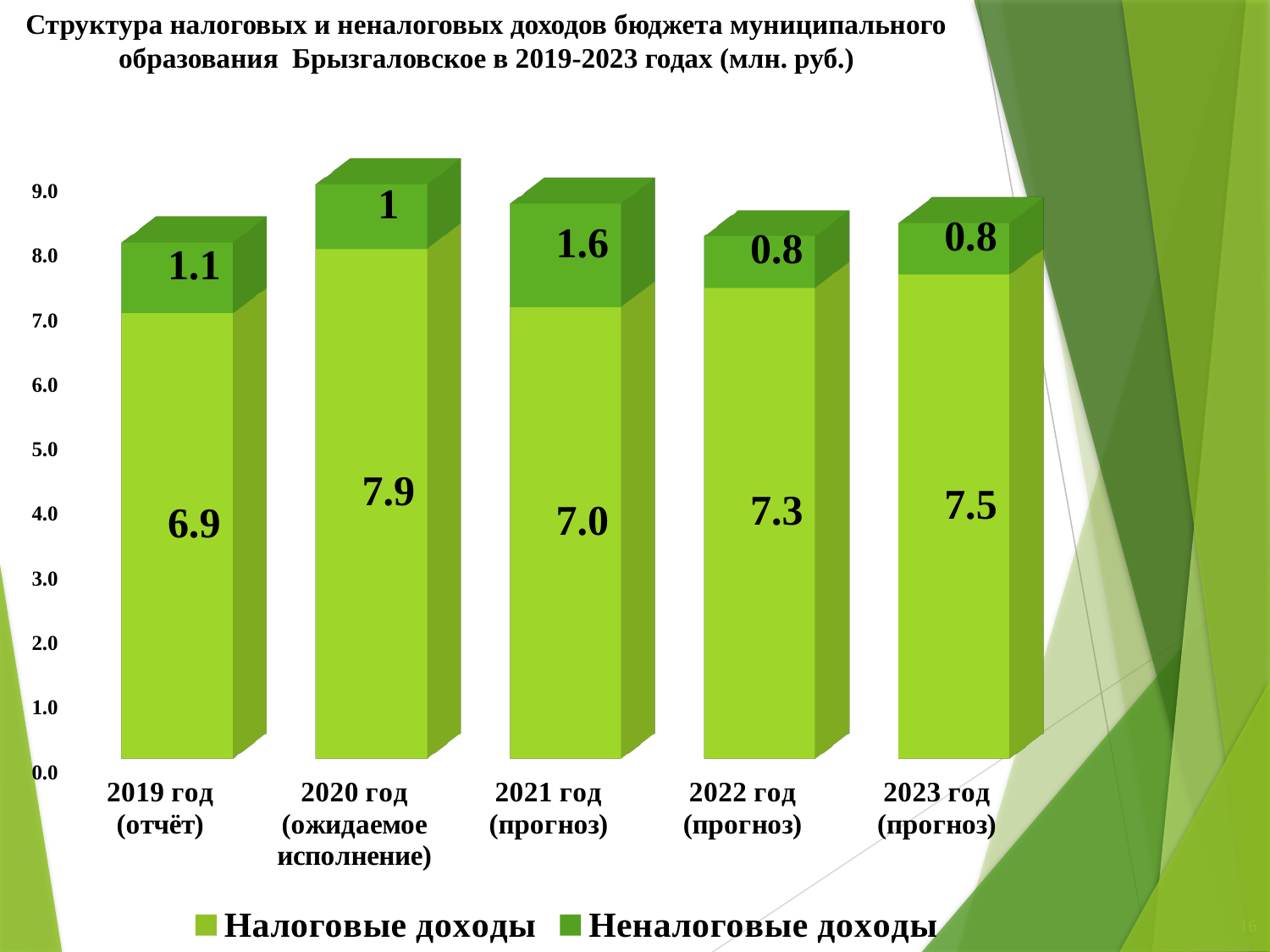
Which year has the highest value of Неналоговые доходы? 2021 год (прогноз) How many series does the legend list? 2 How many years (categories) are shown on the x axis? 5 What is the total of the stacked bar for 2021 год (прогноз)? 8.6 What is the value of Неналоговые доходы for 2021 год (прогноз)? 1.6 What is the difference between Налоговые доходы in 2020 год and in 2019 год? 1.0 Is the value of Налоговые доходы larger in 2023 год (прогноз) or in 2022 год (прогноз)? 2023 год (прогноз) Which year has the highest value of Налоговые доходы? 2020 год (ожидаемое исполнение) What is the value of Неналоговые доходы for 2020 год (ожидаемое исполнение)? 1 What is the value of Налоговые доходы for 2019 год (отчёт)? 6.9 What kind of chart is shown on the slide? Stacked bar chart Which year has the lowest value of Налоговые доходы? 2019 год (отчёт)